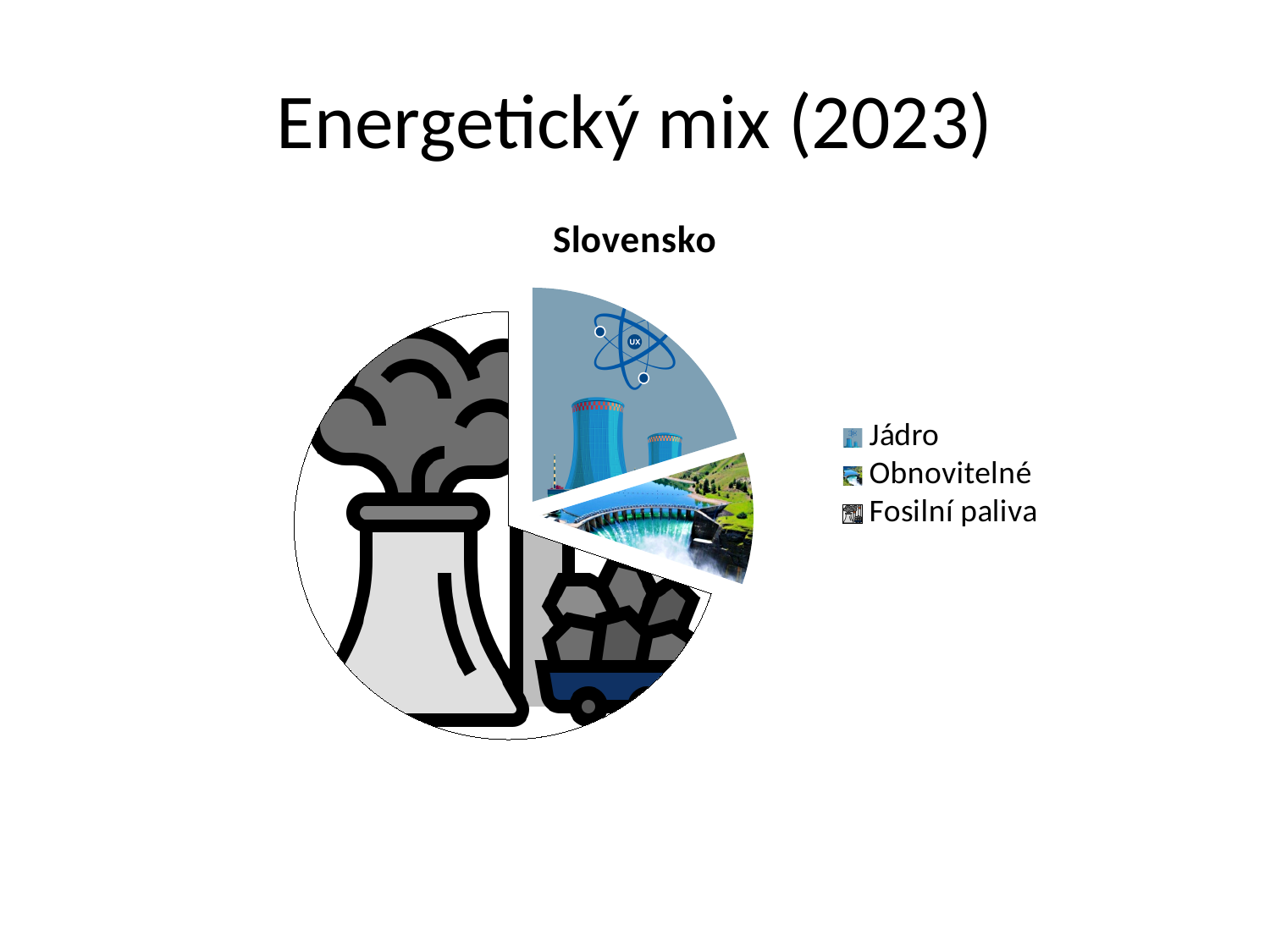
Which slice is larger, Fosilní paliva or Obnovitelné? Fosilní paliva How many slices does the pie chart have? 3 Which category has the largest slice of the pie? Fosilní paliva Which slice is larger, Jádro or Obnovitelné? Jádro What are the three categories listed in the legend? Jádro, Obnovitelné, Fosilní paliva What is the title of the chart? Slovensko How many entries does the legend list? 3 Which slice is larger, Fosilní paliva or Jádro? Fosilní paliva Which category has the smallest slice of the pie? Obnovitelné What kind of chart is shown on the slide? pie chart